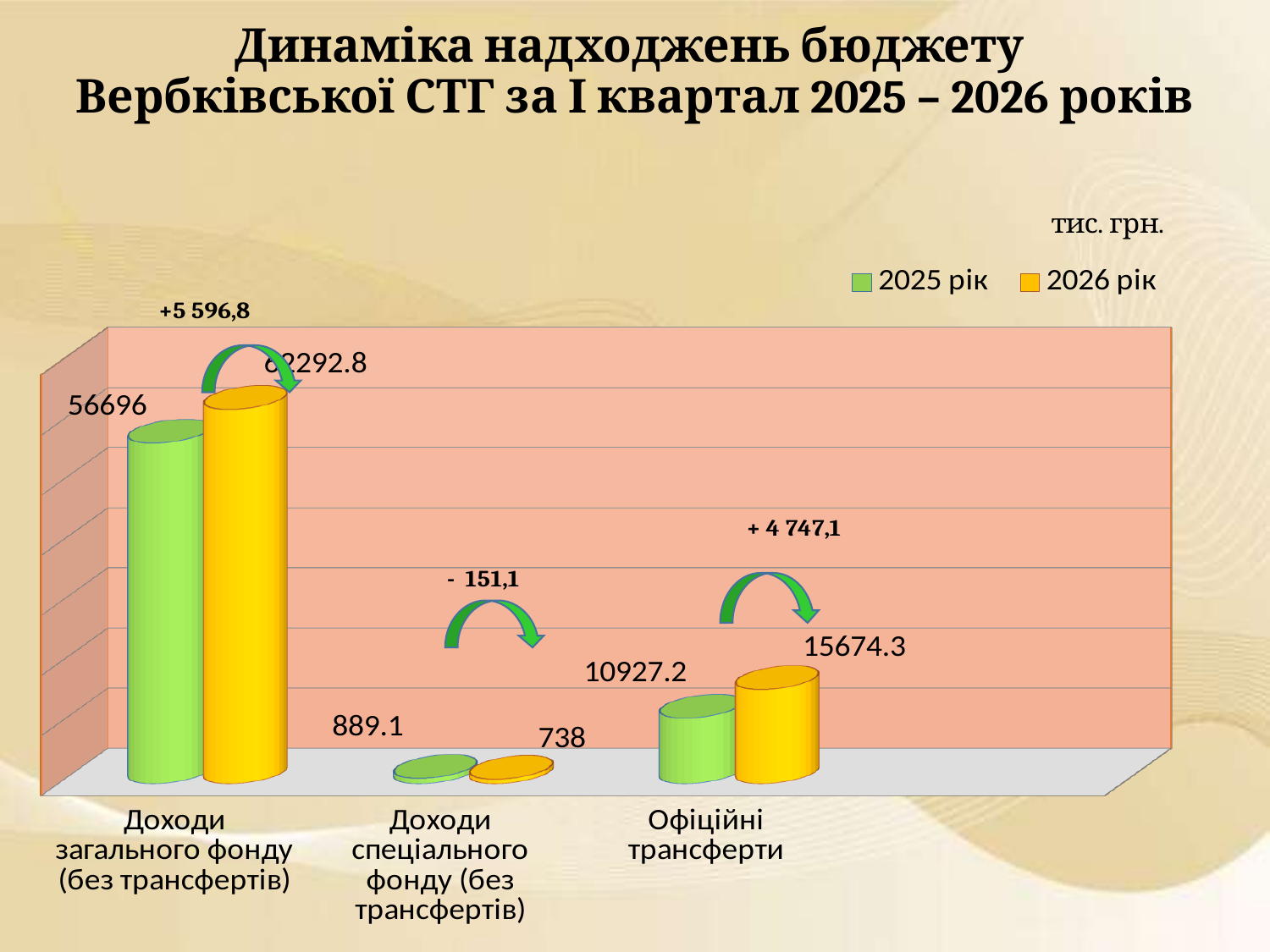
Which category has the lowest value for 2025 рік? Доходи спеціального фонду (без трансфертів) What is the value for Офіційні трансферти in 2026 рік? 15674.3 For Доходи спеціального фонду (без трансфертів), which year has the larger value, 2025 рік or 2026 рік? 2025 рік What kind of chart is shown on the slide? bar chart What is the difference between the 2026 рік and 2025 рік values for Офіційні трансферти? 4747.1 What is the value for Доходи загального фонду (без трансфертів) in 2025 рік? 56696 Which category has the highest value for 2026 рік? Доходи загального фонду (без трансфертів) How many series does the legend list? 2 How many categories are shown on the x axis? 3 What is the value for Офіційні трансферти in 2025 рік? 10927.2 What is the value for Доходи спеціального фонду (без трансфертів) in 2026 рік? 738 What is the value for Доходи спеціального фонду (без трансфертів) in 2025 рік? 889.1